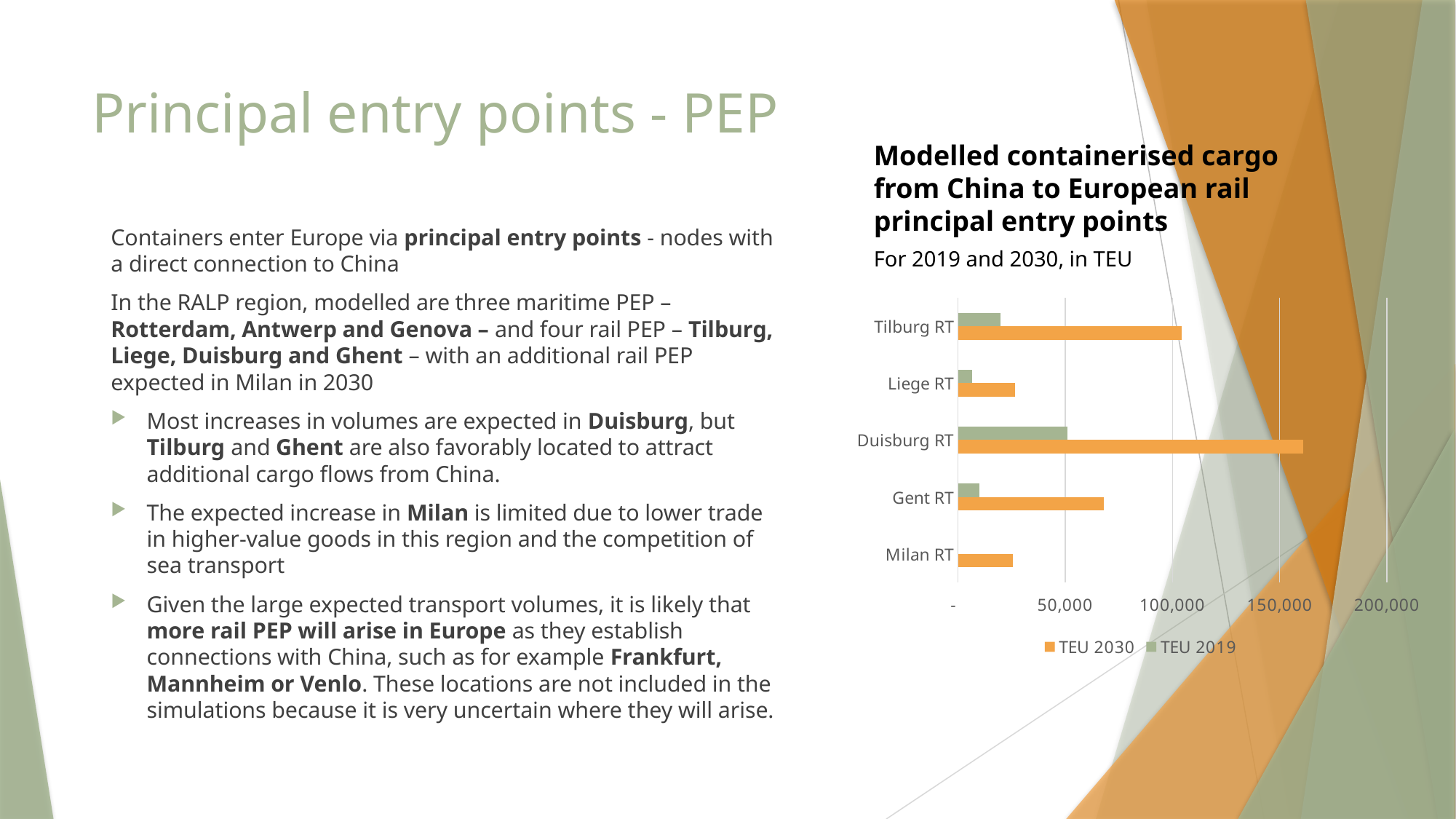
Is the TEU 2030 value for Liege RT greater or less than 50,000? less Which has the larger TEU 2030 value, Tilburg RT or Gent RT? Tilburg RT Is the TEU 2030 value for Gent RT greater or less than 50,000? greater Which entry point has the highest TEU 2030 value? Duisburg RT How many series does the chart legend list? 2 Which series is shown in orange in the chart? TEU 2030 Is the TEU 2030 value for Tilburg RT greater or less than 100,000? greater Which entry point has the lowest TEU 2019 value? Milan RT How many entry points (categories) are plotted in the chart? 5 What kind of chart is shown on the slide? bar chart Which has the larger TEU 2019 value, Duisburg RT or Tilburg RT? Duisburg RT